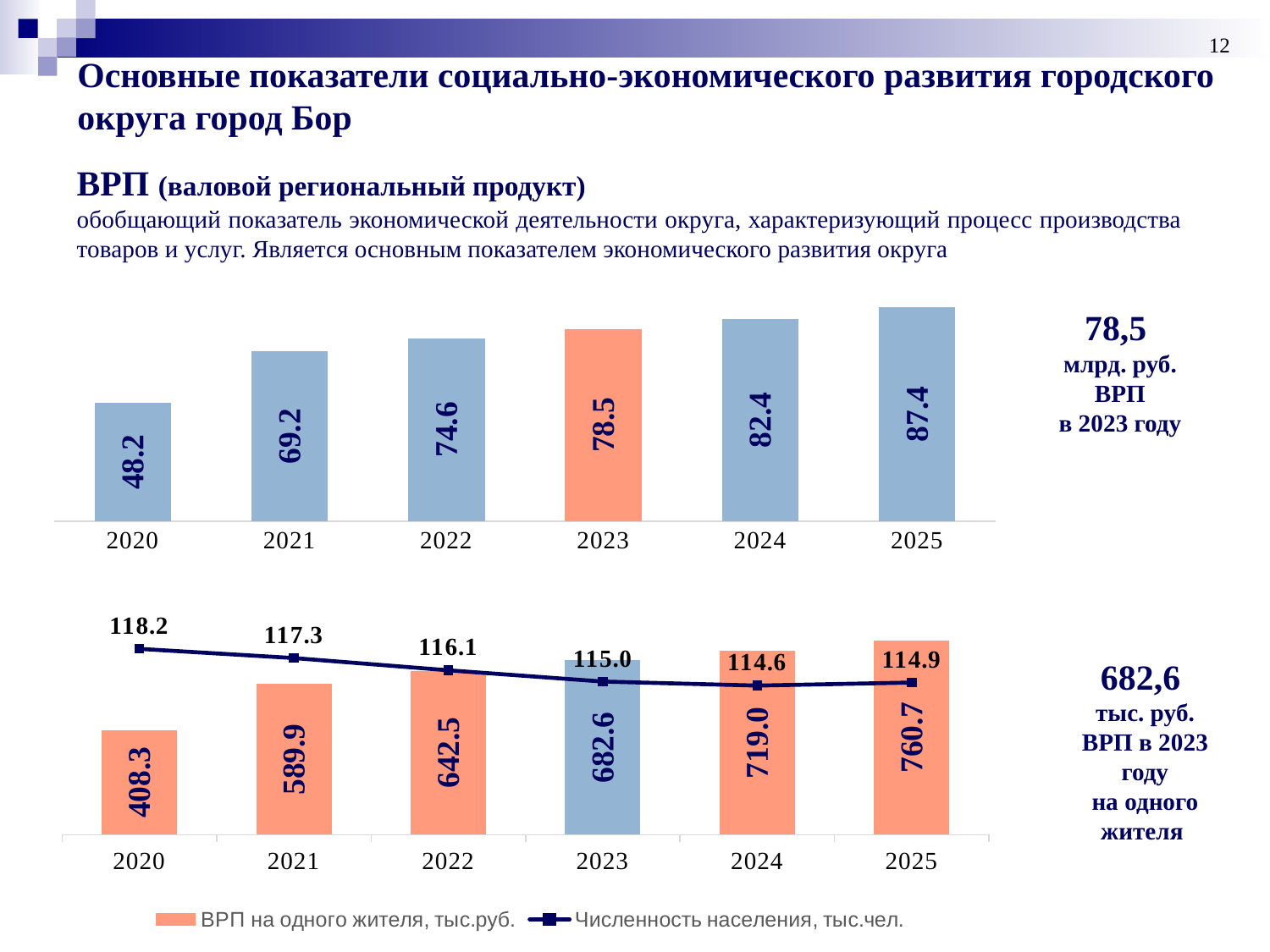
In the bottom chart, which year has the lowest value of Численность населения, тыс.чел.? 2024 In the top chart, what is the difference between the values for 2025 and 2020? 39.2 In the top chart, which year has the lowest value? 2020 In the top chart, do the values rise or fall from 2020 to 2025? rise In the bottom chart, what is the value of ВРП на одного жителя, тыс.руб. for 2021? 589.9 In the bottom chart, what is the difference between ВРП на одного жителя, тыс.руб. for 2024 and 2023? 36.4 In the bottom chart, which year has the highest value of ВРП на одного жителя, тыс.руб.? 2025 In the top chart, what is the value for 2023? 78.5 In the bottom chart, what is the value of Численность населения, тыс.чел. for 2022? 116.1 In the top chart, how many years are shown on the x axis? 6 In the bottom chart, how many series does the legend list? 2 In the bottom chart, which series is drawn as a line? Численность населения, тыс.чел.